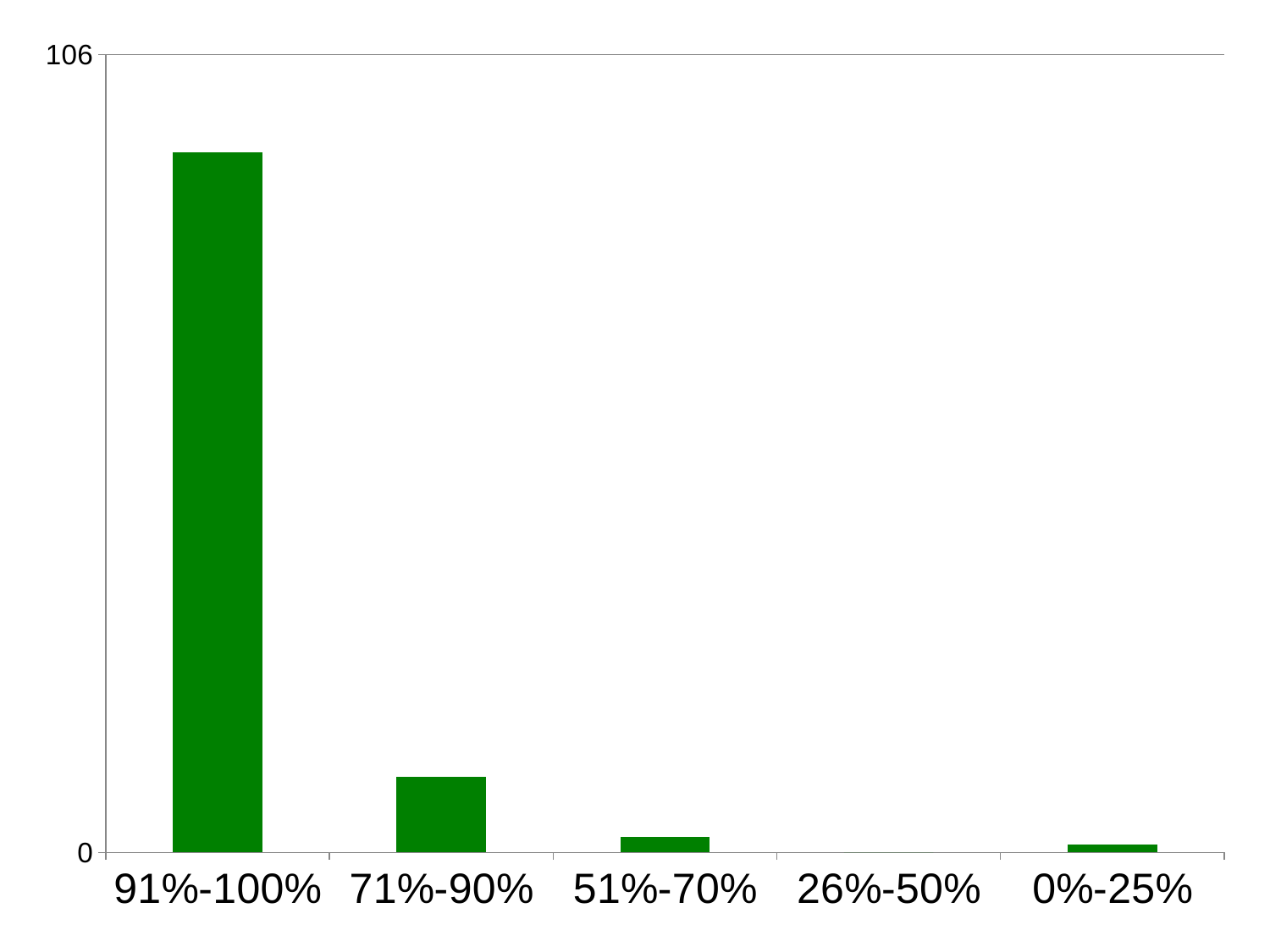
Which is larger, the value for 51%-70% or the value for 0%-25%? 51%-70% What is the label of the rightmost category on the x axis? 0%-25% Which category has the highest bar? 91%-100% What kind of chart is shown on the slide? bar chart What is the highest value labelled on the y axis? 106 Do the bar values generally rise or fall from left to right along the x axis? fall What colour are the bars in the chart? green Which is larger, the value for 71%-90% or the value for 51%-70%? 71%-90% Which is larger, the value for 91%-100% or the value for 71%-90%? 91%-100% How many categories are shown on the x axis? 5 What is the label of the leftmost category on the x axis? 91%-100% Which category has the lowest value? 26%-50%